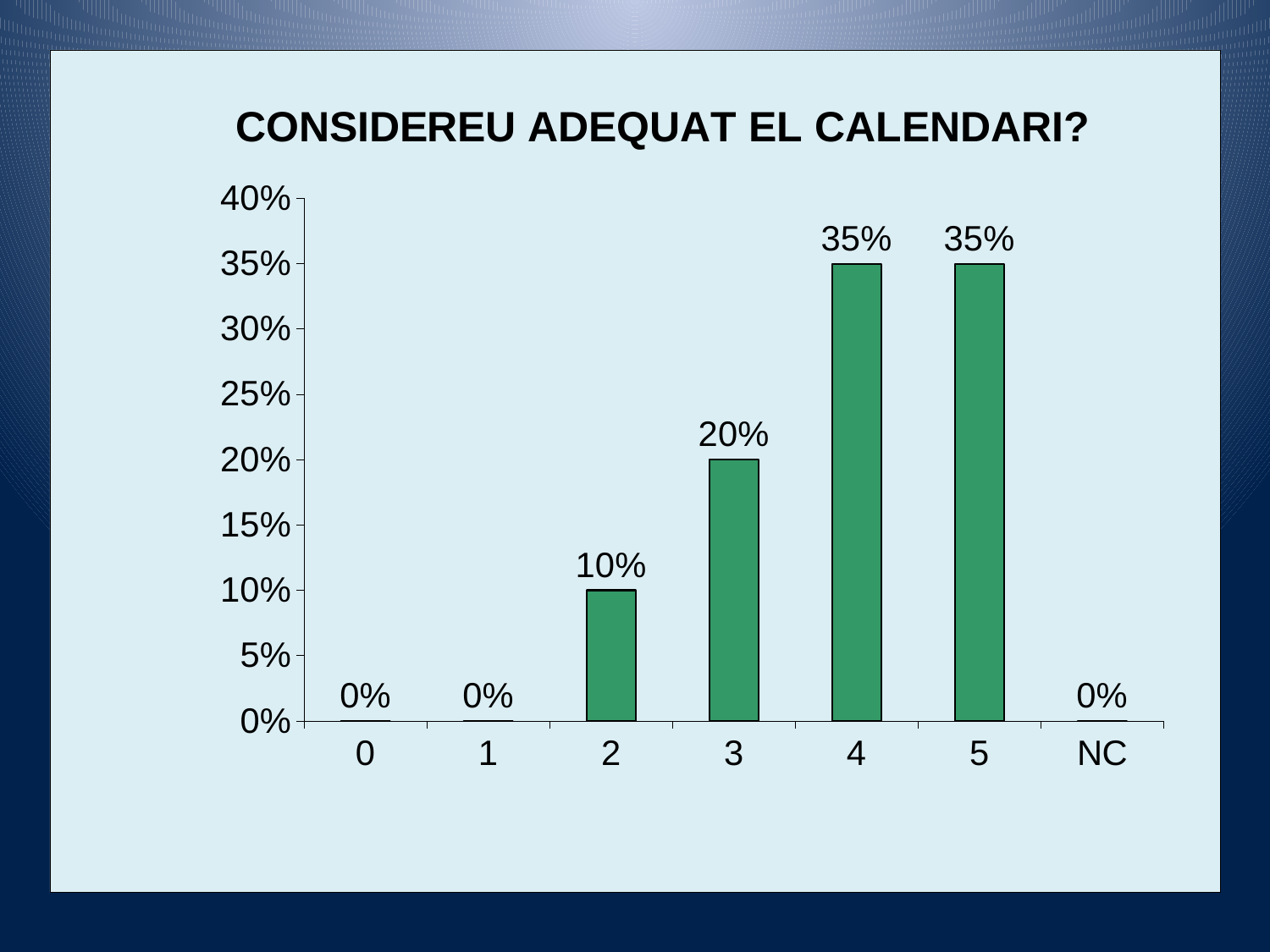
What is the difference between the values for category 3 and category 2? 10% What is the value for category 3? 20% What is the value for category 4? 35% Which is larger, the value for category 2 or the value for category 3? 3 Is the value for category 5 greater or less than 30%? greater What is the title of the chart? CONSIDEREU ADEQUAT EL CALENDARI? What kind of chart is shown on the slide? bar chart What is the value for category 2? 10% What is the value for category NC? 0% How many categories are shown on the x axis? 7 Which categories have the highest value? 4 and 5 What is the difference between the values for category 4 and category 3? 15%